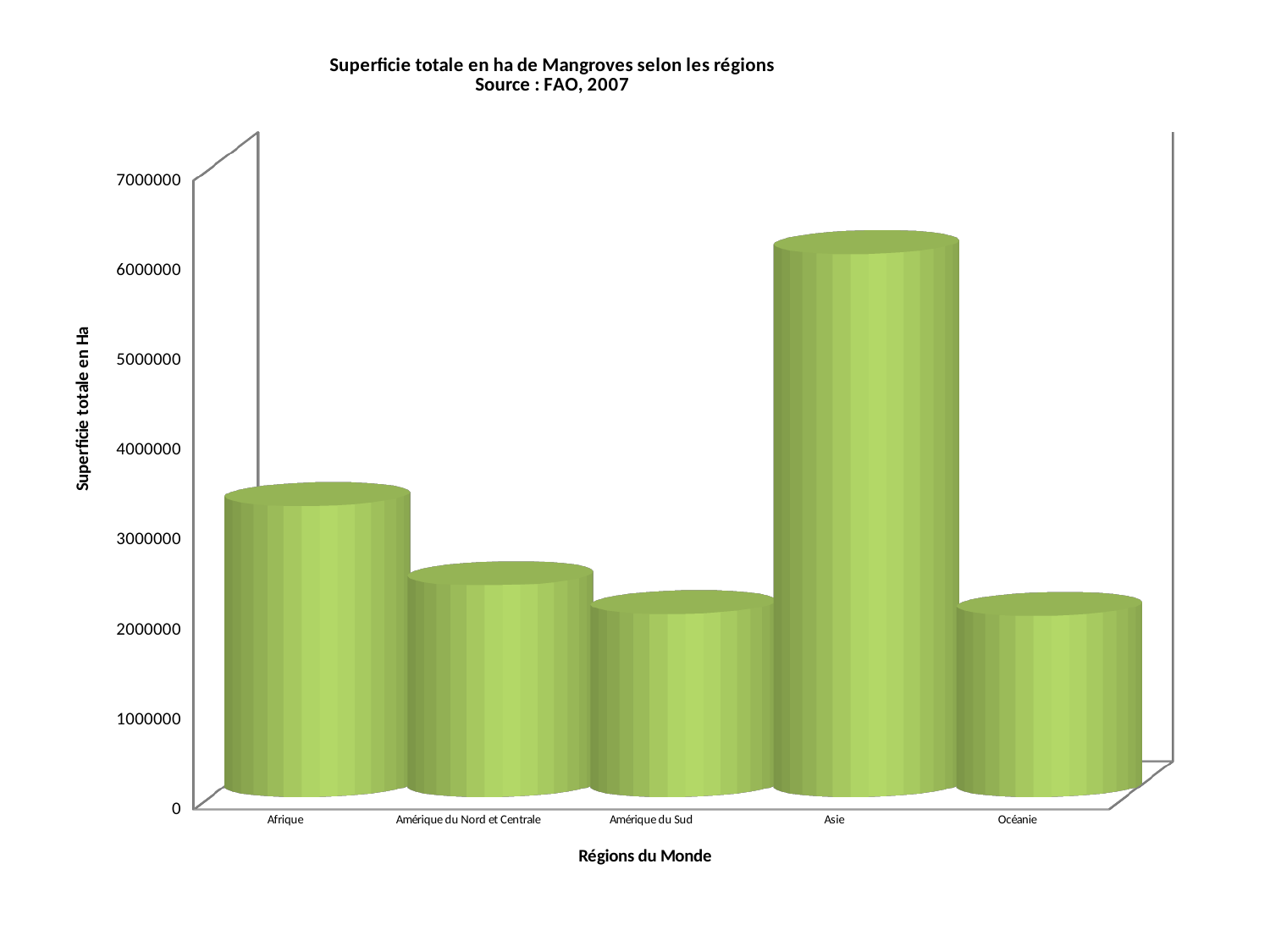
What kind of chart is shown on the slide? bar chart Which is larger, the value for Asie or the value for Océanie? Asie Is the value for Afrique greater or less than 3000000? greater Is the value for Afrique greater or less than 4000000? less Which is larger, the value for Afrique or the value for Amérique du Nord et Centrale? Afrique Is the value for Asie greater or less than 5000000? greater What is the label of the y axis? Superficie totale en Ha How many regions are plotted on the x axis? 5 What is the title of the chart? Superficie totale en ha de Mangroves selon les régions Source : FAO, 2007 Which region has the highest total mangrove area? Asie